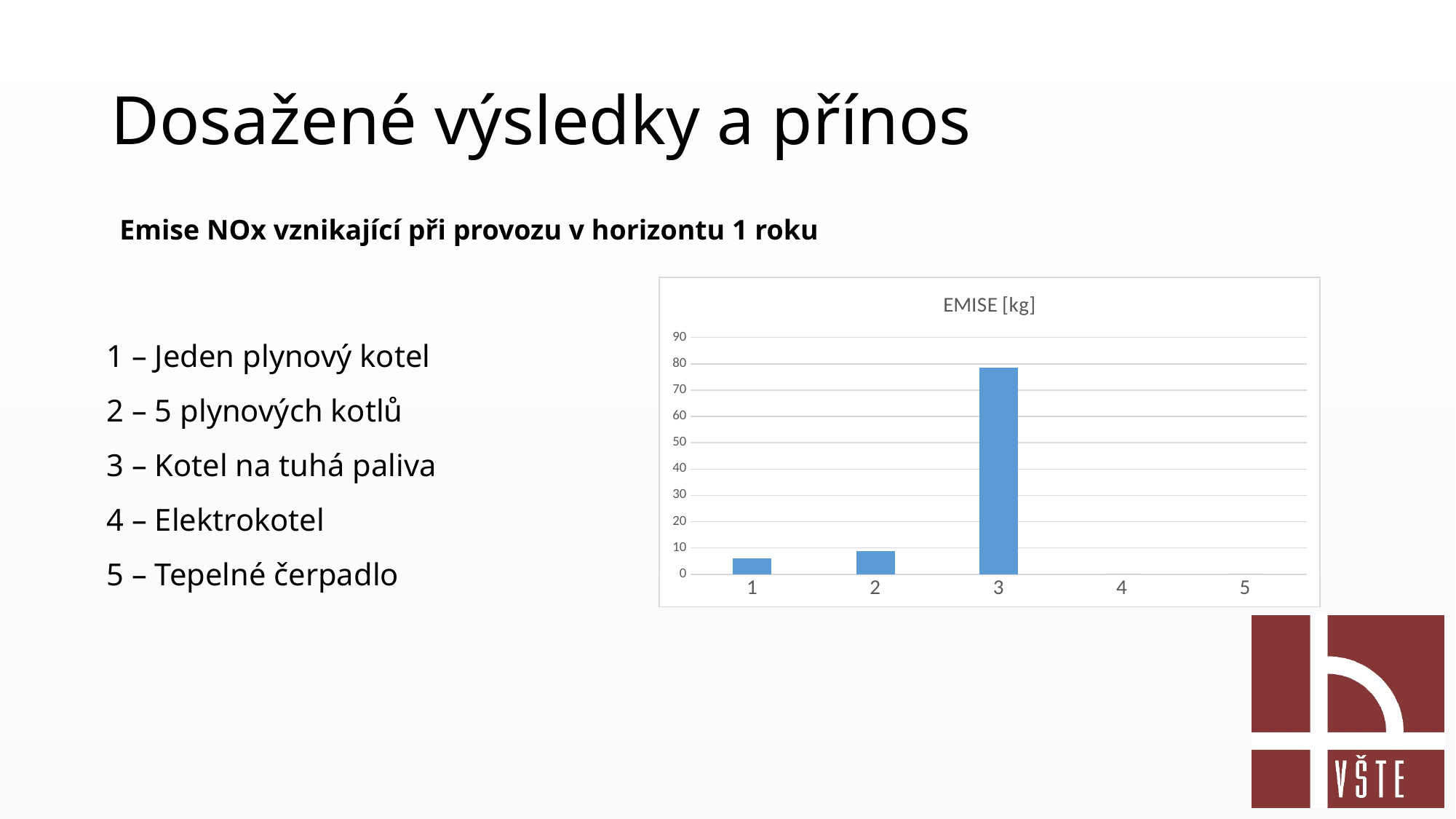
Which is larger, the value for category 3 or the value for category 2? 3 Is the value for category 2 greater or less than 10? less Is the value for category 1 greater or less than 10? less How many categories are shown on the x axis of the chart? 5 What is the title of the chart? EMISE [kg] Is the value for category 3 greater or less than 70? greater Which category has the highest value in the chart? 3 Which is larger, the value for category 2 or the value for category 1? 2 What kind of chart is shown on the slide? bar chart What is the highest value shown on the vertical axis of the chart? 90